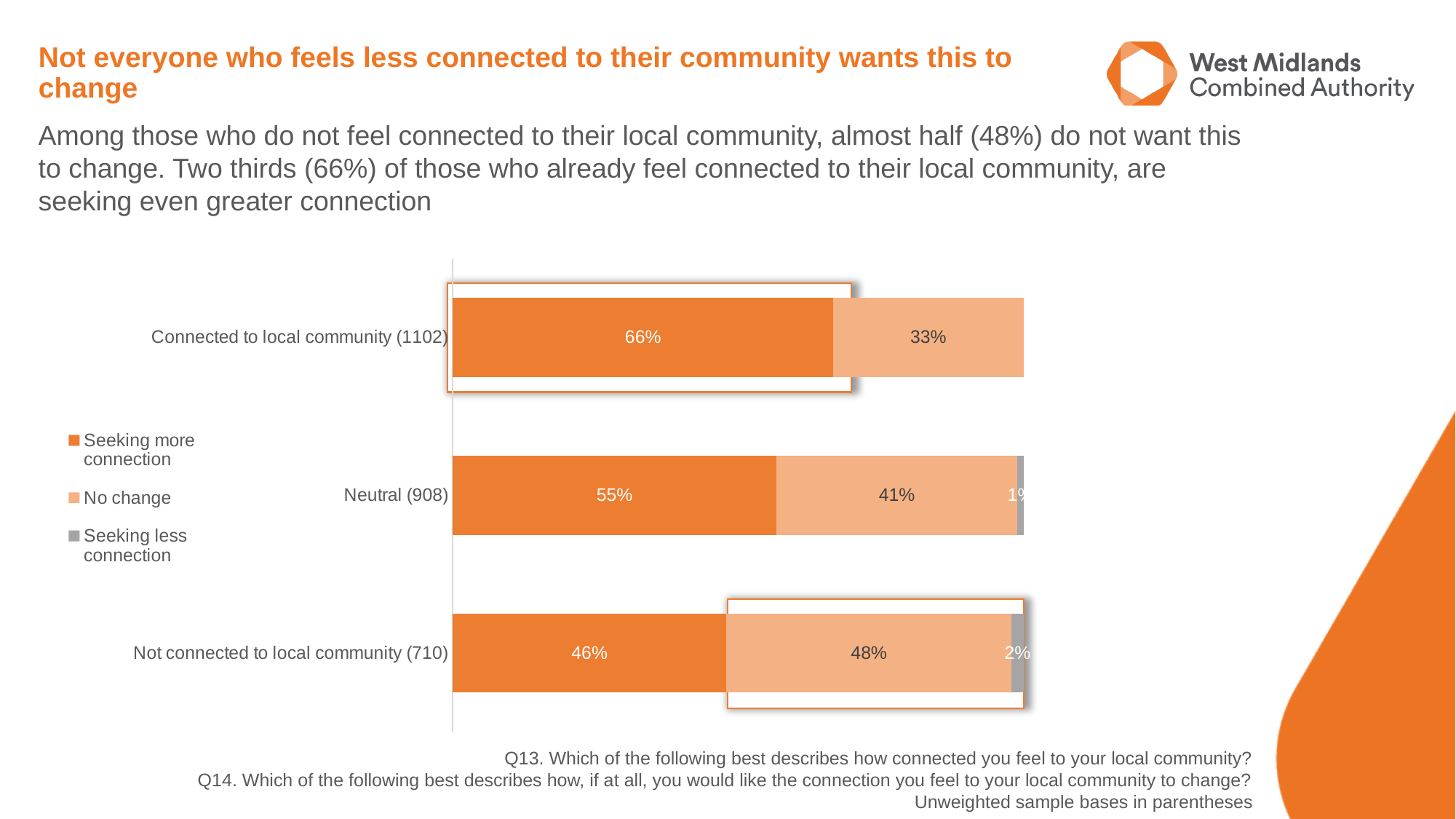
For the Neutral group, which is larger: 'Seeking more connection' or 'No change'? Seeking more connection What type of chart is shown on the slide? Stacked bar chart How many series does the legend list? 3 What is the 'No change' value for the Neutral group? 41% What percentage of those connected to their local community are seeking more connection? 66% What is the unweighted sample base for the Neutral group? 908 What percentage of those not connected to their local community are seeking less connection? 2% How many groups (categories) are shown in the chart? 3 Which group has the highest share seeking more connection? Connected to local community (1102) What is the 'No change' value for those not connected to their local community? 48% Which group has the lowest share seeking more connection? Not connected to local community (710) What is the difference between the 'Seeking more connection' values for the Connected and Not connected groups? 20 percentage points